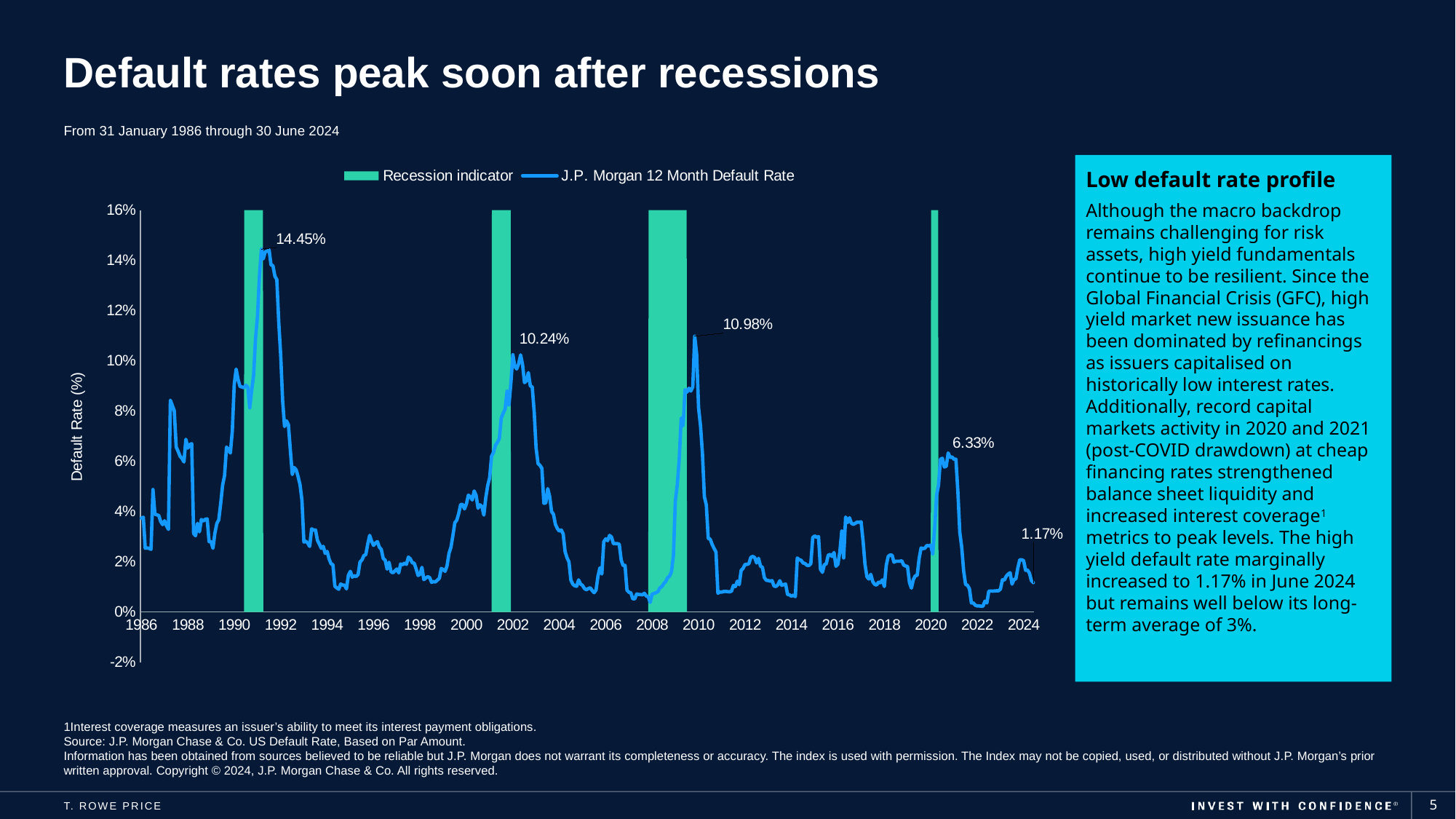
What is the labelled peak of the default rate around 2020-2021? 6.33% What is the labelled peak of the default rate around 2002? 10.24% How many recession indicator bars are shown on the chart? 4 What is the label on the vertical axis of the chart? Default Rate (%) What type of chart is used to show the J.P. Morgan 12 Month Default Rate? Line chart What is the labelled default rate value at the end of the series in 2024? 1.17% What is the difference between the 6.33% peak and the final value of 1.17%? 5.16% What is the highest labelled peak of the J.P. Morgan 12 Month Default Rate on the chart? 14.45% What is the labelled peak of the default rate around 2009-2010? 10.98% Which labelled peak is larger: the one around 2002 (10.24%) or the one around 2009-2010 (10.98%)? 10.98% What is the difference between the 14.45% peak and the 10.98% peak? 3.47% How many series does the legend list? 2